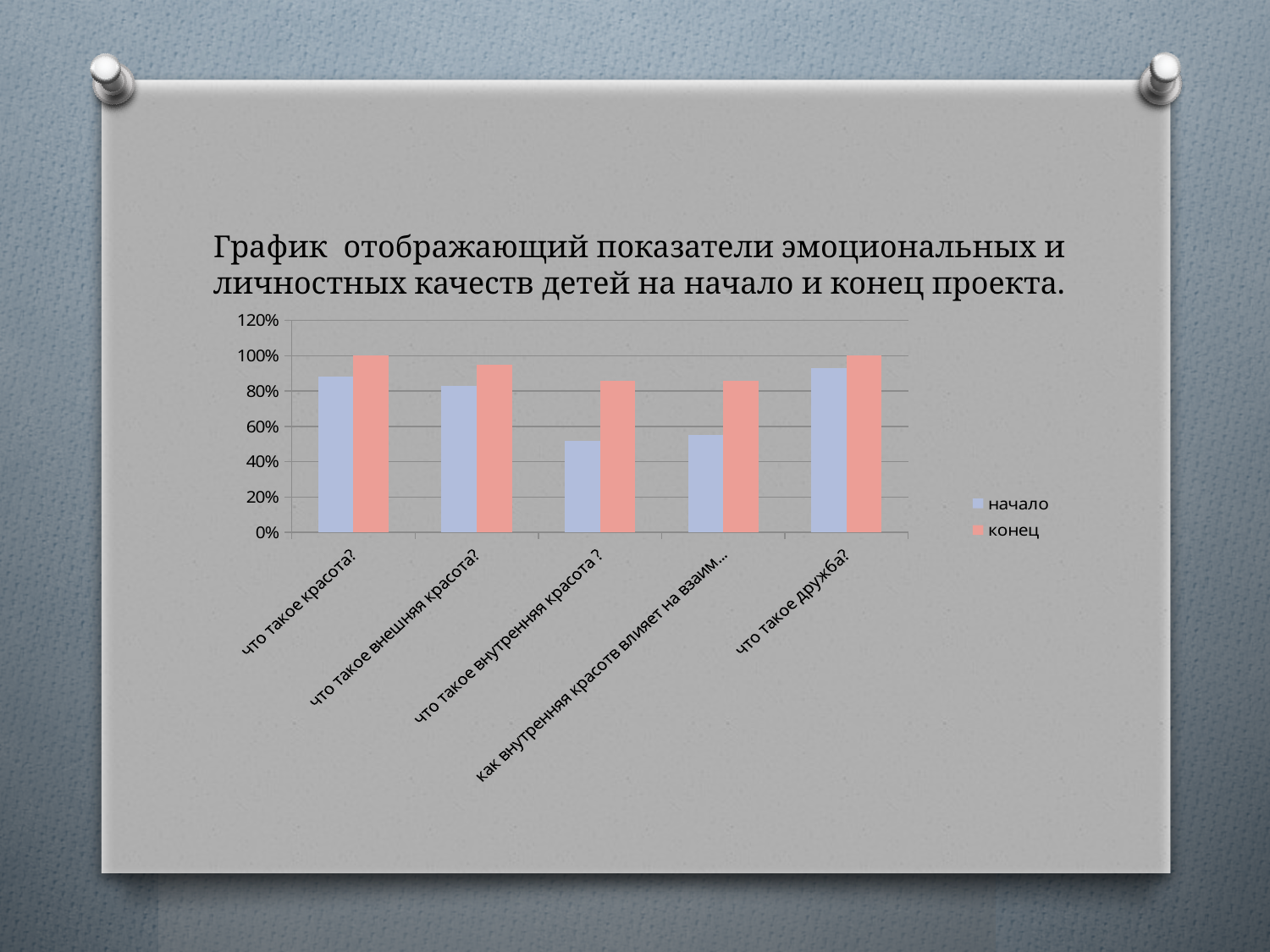
What is the value of the "конец" series for "что такое красота?"? 100% Which category has the highest "начало" value? что такое дружба? What kind of chart is shown on the slide? bar chart What are the two series named in the legend? начало, конец How many categories are shown on the x axis? 5 Is the "конец" value for "что такое внешняя красота?" greater or less than 80%? greater Is the "начало" value for "что такое красота?" greater or less than 80%? greater What is the value of the "конец" series for "что такое дружба?"? 100% Which is larger: the "начало" value for "что такое красота?" or the "начало" value for "что такое внутренняя красота ?"? что такое красота? How many series does the legend list? 2 Is the "начало" value for "что такое внутренняя красота ?" greater or less than 60%? less For "что такое внутренняя красота ?", which series has the larger value, "начало" or "конец"? конец